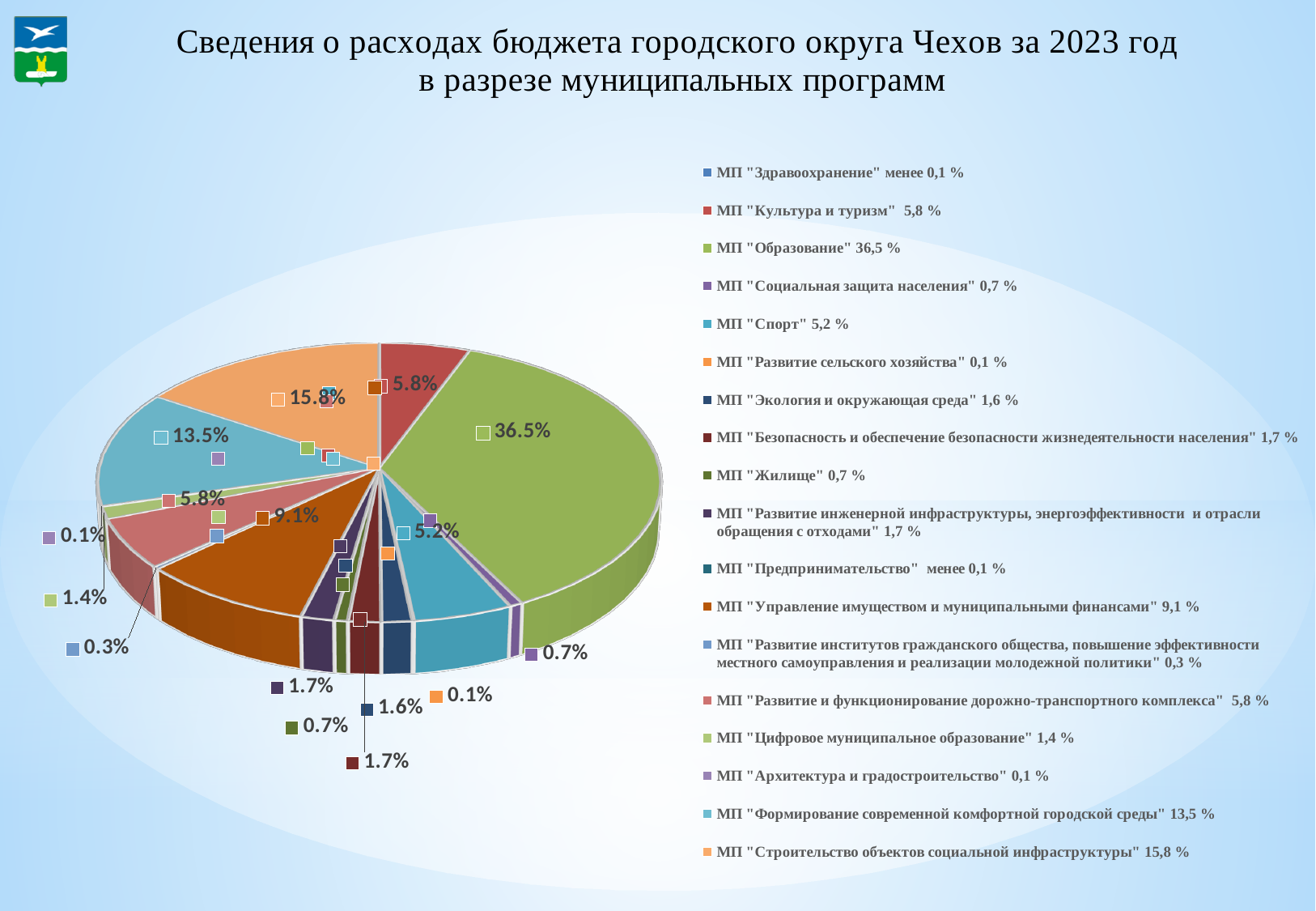
Which has the larger share: МП "Спорт" or МП "Культура и туризм"? МП "Культура и туризм" What year does the budget expenditure chart on the slide refer to? 2023 What share of expenditure does МП "Строительство объектов социальной инфраструктуры" account for? 15.8% What share of expenditure does МП "Экология и окружающая среда" account for? 1.6% What kind of chart is shown on the slide? pie chart What share of expenditure does МП "Образование" account for? 36.5% How many municipal programmes are listed in the chart legend? 18 What share of expenditure does МП "Формирование современной комфортной городской среды" account for? 13.5% What share of expenditure does МП "Управление имуществом и муниципальными финансами" account for? 9.1% By how many percentage points does the share of МП "Строительство объектов социальной инфраструктуры" exceed that of МП "Формирование современной комфортной городской среды"? 2.3 percentage points Which municipal programme has the largest share of the 2023 budget expenditure in the pie chart? МП "Образование" Which has the larger share: МП "Образование" or МП "Строительство объектов социальной инфраструктуры"? МП "Образование"